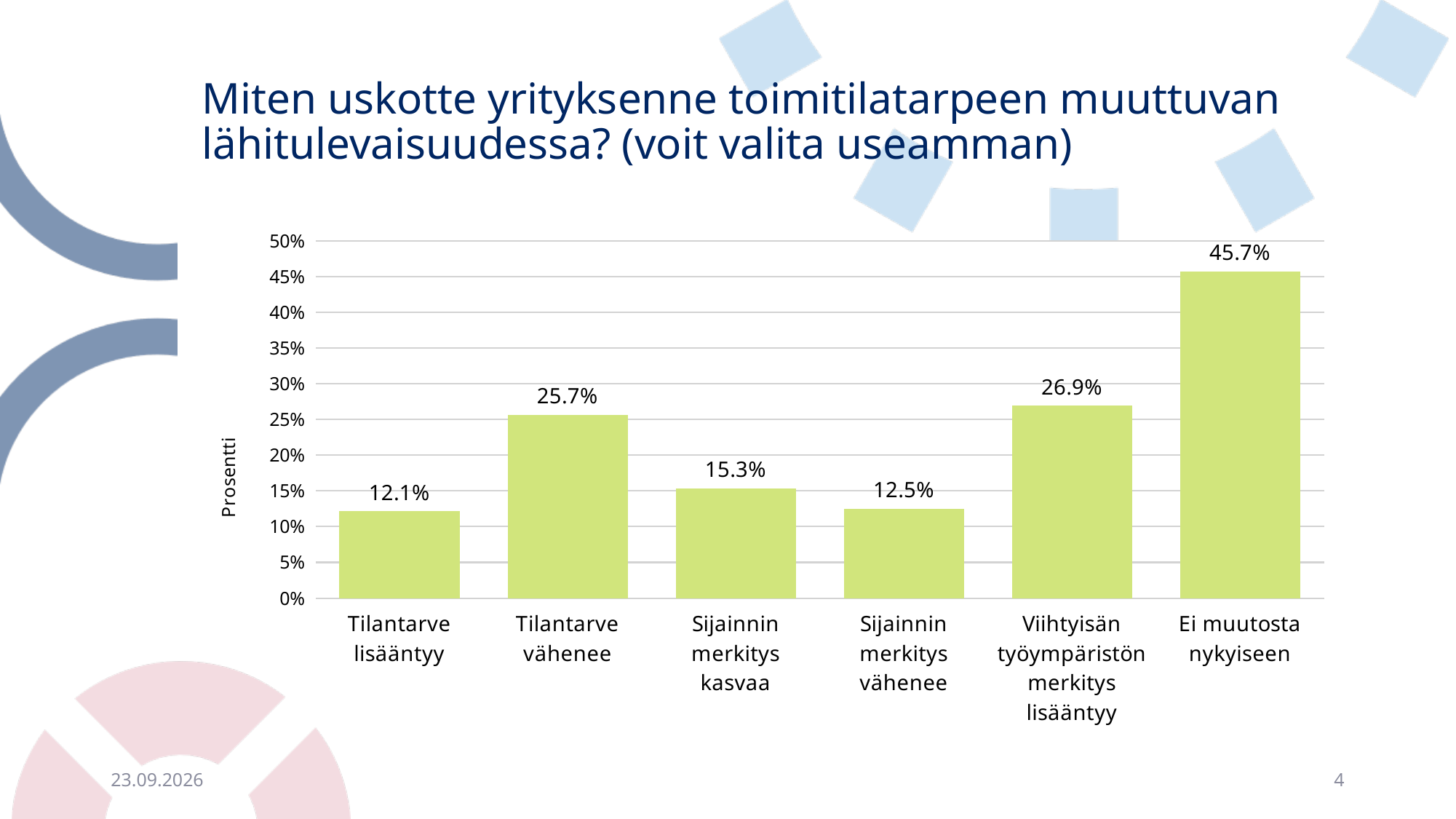
What is the label of the vertical axis? Prosentti Is the value for "Sijainnin merkitys vähenee" greater or less than 15%? less What is the difference between the values for "Ei muutosta nykyiseen" and "Tilantarve vähenee"? 20.0% What is the value for "Sijainnin merkitys kasvaa"? 15.3% What kind of chart is shown on the slide? bar chart Which category has the lowest value? Tilantarve lisääntyy What is the value for "Viihtyisän työympäristön merkitys lisääntyy"? 26.9% What is the value for "Ei muutosta nykyiseen"? 45.7% How many categories are shown on the x axis? 6 Which is larger: the value for "Viihtyisän työympäristön merkitys lisääntyy" or "Tilantarve vähenee"? Viihtyisän työympäristön merkitys lisääntyy What is the value for "Tilantarve vähenee"? 25.7% Which category has the highest value? Ei muutosta nykyiseen